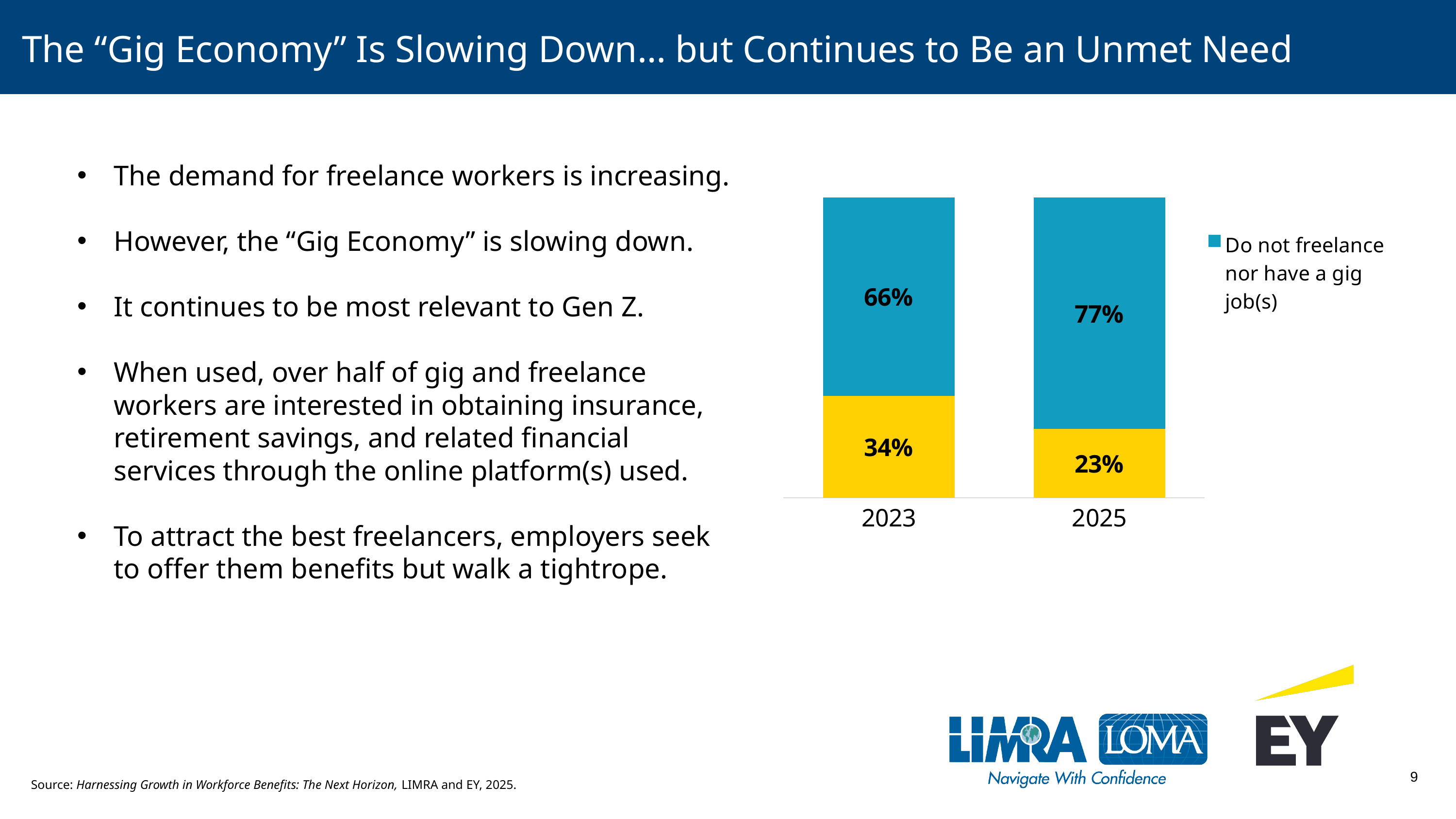
Does the yellow segment rise or fall from 2023 to 2025? Falls Which year has the smaller yellow segment? 2025 By how many percentage points did the 'Do not freelance nor have a gig job(s)' share increase from 2023 to 2025? 11 percentage points What percentage of respondents in 2023 do not freelance nor have a gig job(s)? 66% What type of chart is shown on the slide? Stacked bar chart How many years are shown on the x axis of the chart? 2 What value is shown for the yellow segment of the 2025 bar? 23% By how many percentage points did the yellow segment decrease from 2023 to 2025? 11 percentage points What value is shown for the yellow segment of the 2023 bar? 34% What percentage of respondents in 2025 do not freelance nor have a gig job(s)? 77% What is the total of the two segments in the 2023 bar? 100% Which year has the larger share of respondents who do not freelance nor have a gig job(s), 2023 or 2025? 2025